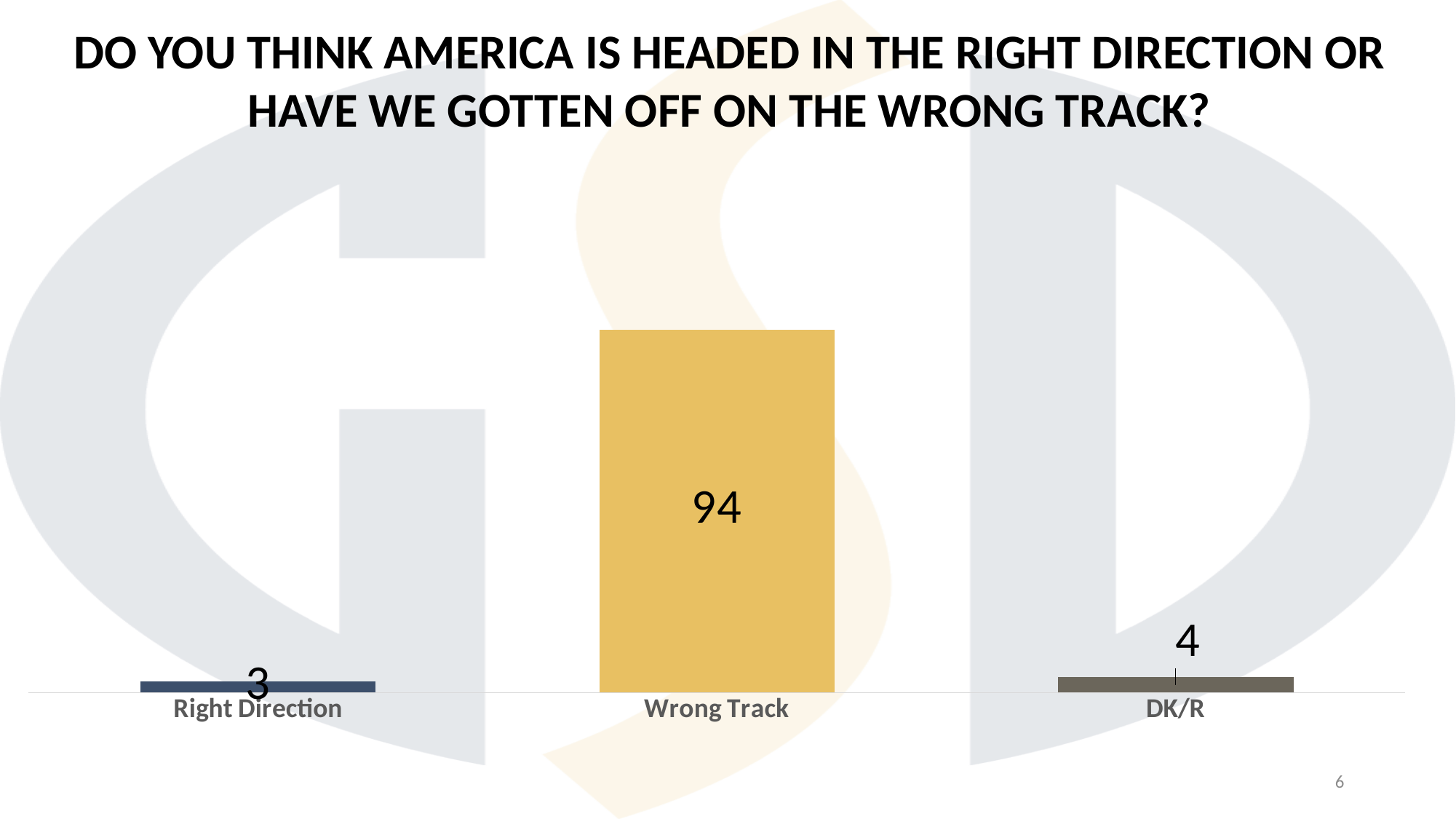
What kind of chart is shown on the slide? Bar chart What is the value for Wrong Track? 94 What is the value for DK/R? 4 What is the difference between the values for Wrong Track and Right Direction? 91 Which category has the lowest value? Right Direction What colour is the Wrong Track bar? Yellow Which category has the highest value? Wrong Track What is the total of the three values shown in the chart? 101 What is the value for Right Direction? 3 How many categories are shown in the chart? 3 Which is larger, the value for Wrong Track or the value for DK/R? Wrong Track What is the difference between the values for DK/R and Right Direction? 1